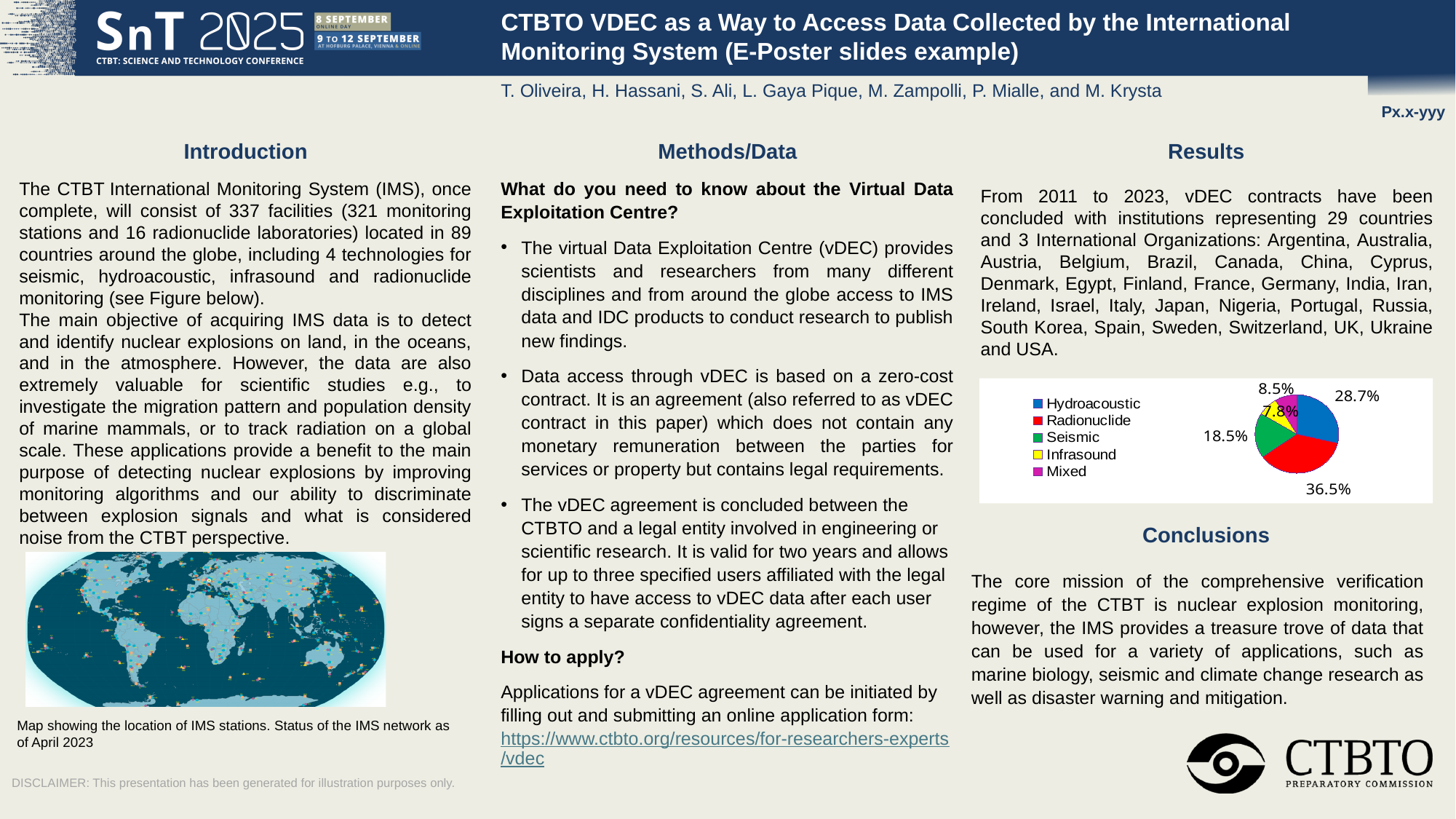
Which category has the smallest slice in the pie chart? Infrasound What kind of chart is shown in the Results section? pie chart How many categories does the pie chart legend list? 5 In the pie chart, what share does Mixed have? 8.5% Which category has the largest slice in the pie chart? Radionuclide In the pie chart, what share does Infrasound have? 7.8% Which slice is larger in the pie chart, Seismic or Mixed? Seismic In the pie chart, what share does Radionuclide have? 36.5% In the pie chart, what share does Hydroacoustic have? 28.7% What colour is the Seismic slice in the pie chart? green What is the difference in percentage points between the Radionuclide and Hydroacoustic slices? 7.8 In the pie chart, what share does Seismic have? 18.5%